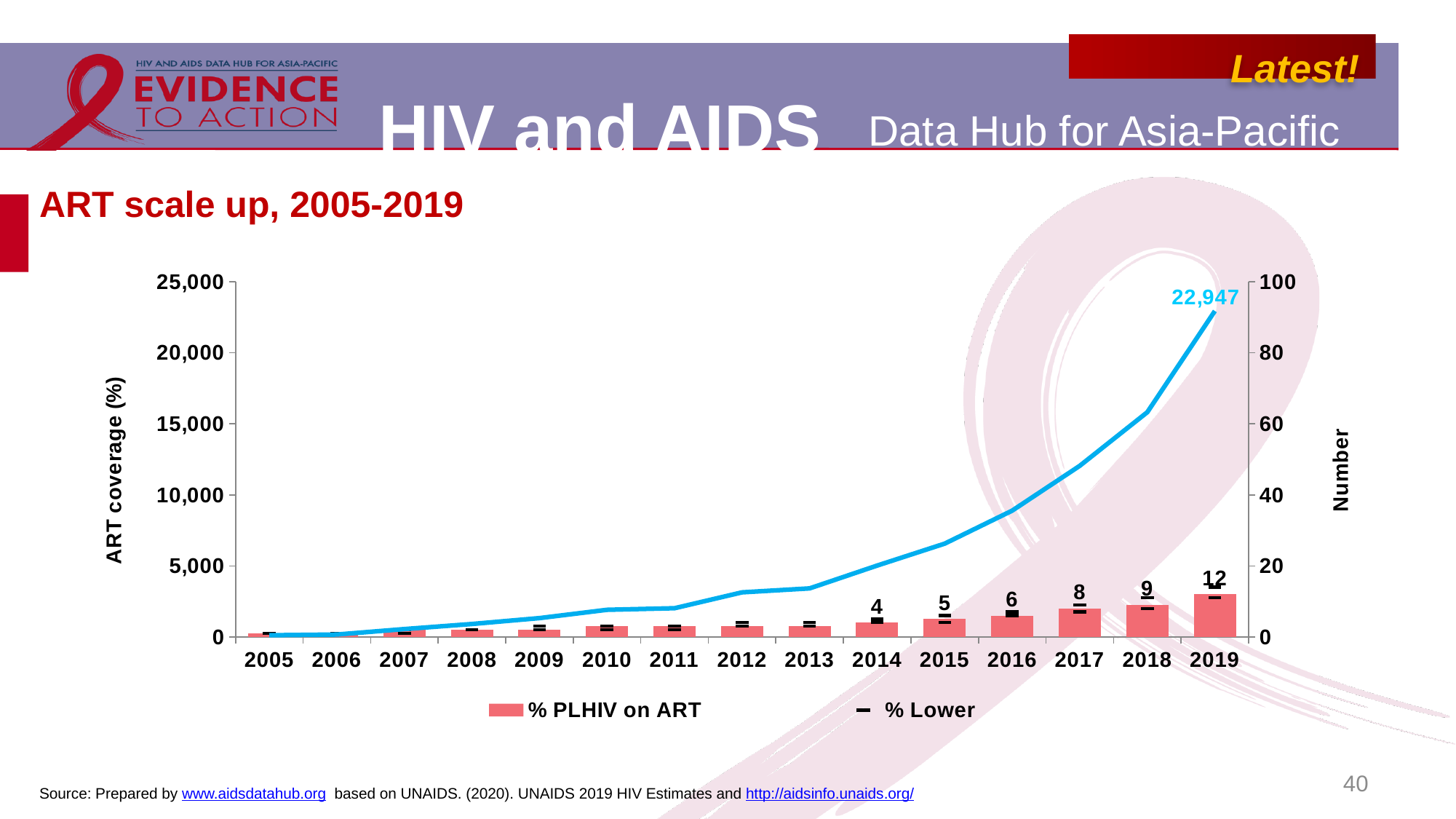
What is the title of the chart? ART scale up, 2005-2019 By how much does the % PLHIV on ART value for 2019 exceed the value for 2014? 8 What is the % PLHIV on ART value shown for 2019? 12 Which year has the highest % PLHIV on ART bar? 2019 What is the % PLHIV on ART value shown for 2017? 8 Is the value of the blue line in 2015 greater or less than 10,000? less How many years are shown on the x axis? 15 What is the % PLHIV on ART value shown for 2015? 5 Which year has the larger % PLHIV on ART bar, 2016 or 2018? 2018 What value is labelled on the blue line for 2019? 22,947 How many entries does the legend list? 2 Does the blue line rise or fall from 2005 to 2019? rises